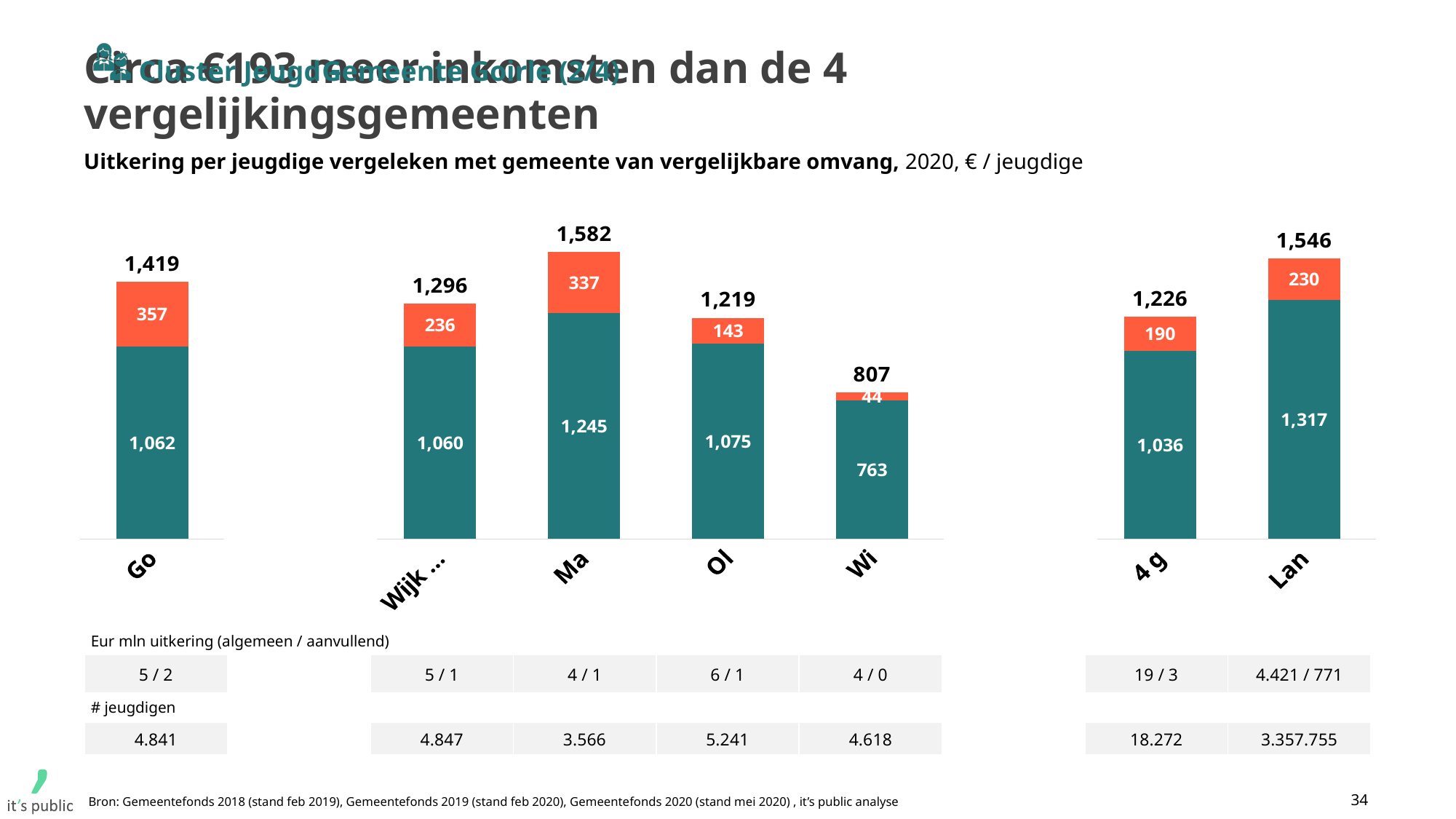
In the middle chart, what is the total value shown above the bar for Ma? 1,582 In the right chart, what is the value of the orange (upper) segment of the bar for 4 g? 190 In the middle chart, which category has the highest total? Ma What is the difference between the total for Go in the left chart and the total for 4 g in the right chart? 193 In the left chart, what is the value of the teal (lower) segment of the bar for Go? 1,062 How many categories are shown in the middle chart? 4 In the middle chart, what is the value of the orange (upper) segment of the bar for Ol? 143 What kind of chart is used on this slide? Stacked bar chart In the middle chart, what is the difference between the total for Ma and the total for Wi? 775 According to the subtitle, in what unit are the values on the charts expressed? € / jeugdige In the middle chart, which category has the lowest total? Wi In the right chart, which has the larger total, 4 g or Lan? Lan